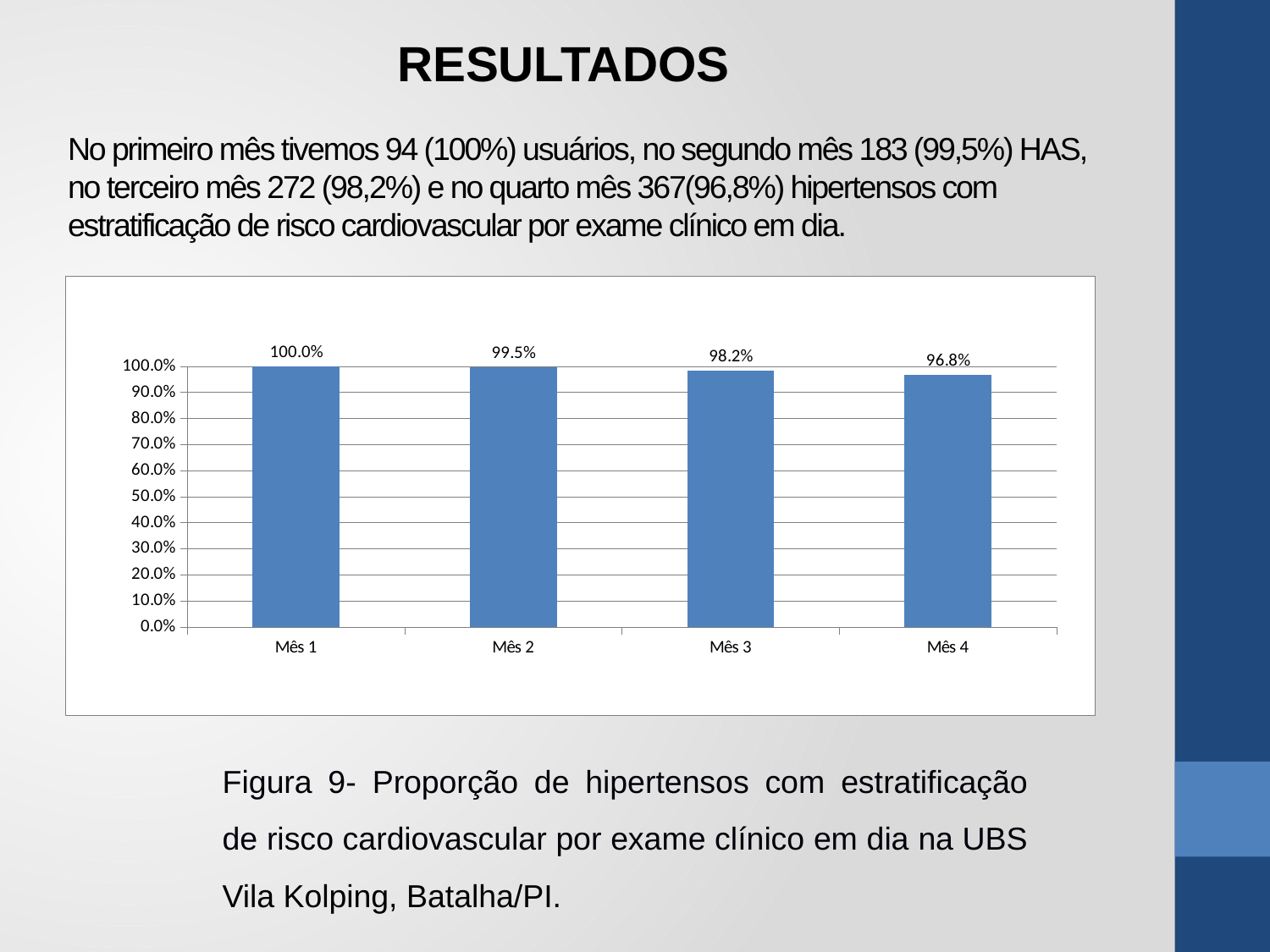
What is the value for Mês 1? 100.0% Which month has the highest value? Mês 1 What kind of chart is shown on the slide? Bar chart How many months are shown on the x axis? 4 What is the value for Mês 4? 96.8% Which is larger, the value for Mês 2 or the value for Mês 4? Mês 2 What is the value for Mês 2? 99.5% What is the difference between the values for Mês 2 and Mês 3? 1.3% What is the difference between the values for Mês 1 and Mês 4? 3.2% Which month has the lowest value? Mês 4 Do the values rise or fall from Mês 1 to Mês 4? Fall What is the value for Mês 3? 98.2%